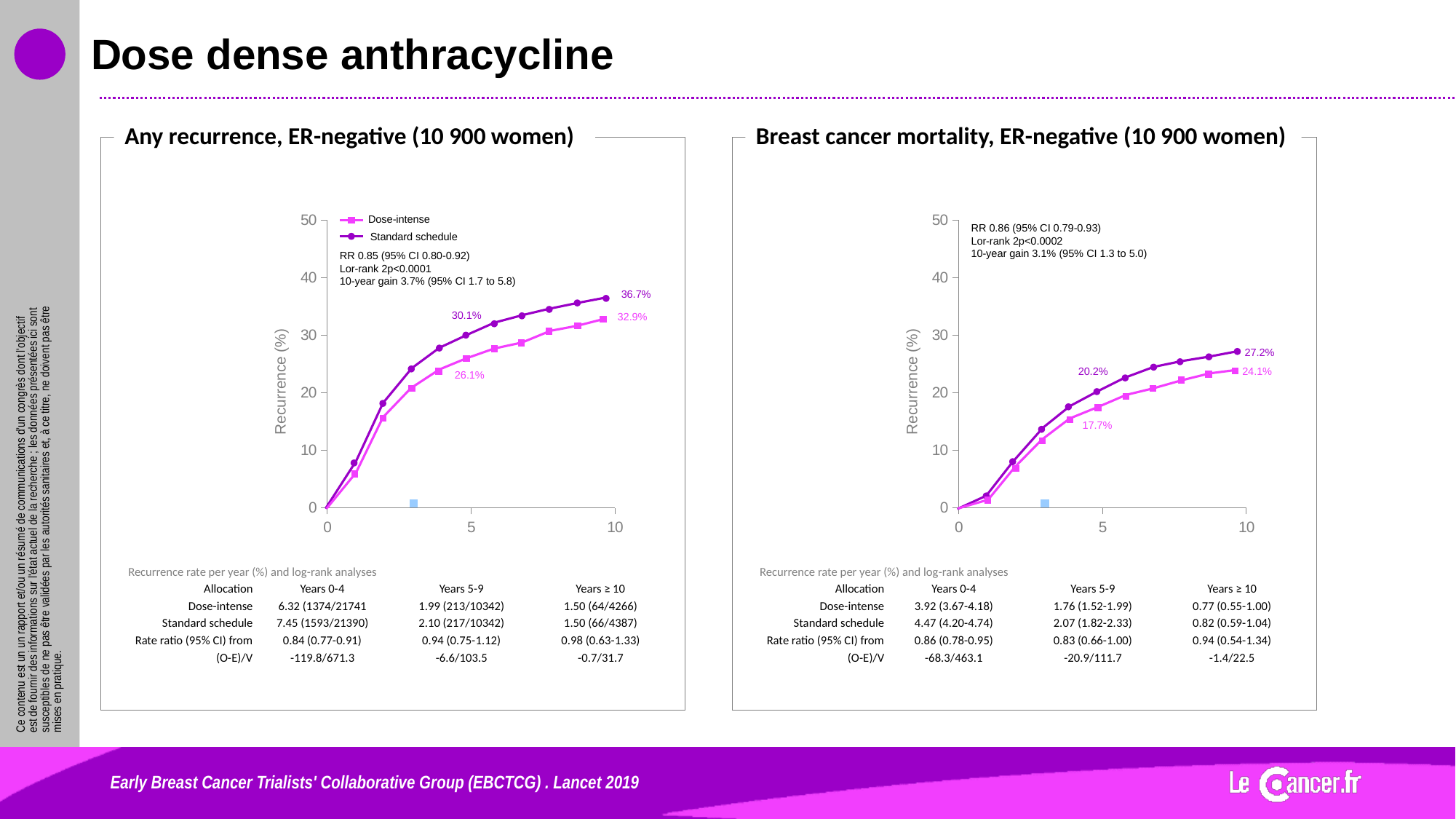
In the 'Breast cancer mortality, ER-negative' chart, what is the 10-year value labelled for the Standard schedule line? 27.2% In the 'Any recurrence, ER-negative' chart, what is the 5-year value labelled for the Dose-intense line? 26.1% What kind of chart is the 'Breast cancer mortality, ER-negative' chart? Line chart In the 'Breast cancer mortality, ER-negative' chart, what is the difference between the 5-year values of the Standard schedule and Dose-intense lines? 2.5% In the 'Any recurrence, ER-negative' chart, is the 10-year value for the Dose-intense line greater or less than 30? greater How many series does the legend of the 'Any recurrence, ER-negative' chart list? 2 In the 'Breast cancer mortality, ER-negative' chart, which line is higher at 10 years, Dose-intense or Standard schedule? Standard schedule In the 'Any recurrence, ER-negative' chart, what is the 10-year recurrence value labelled for the Standard schedule line? 36.7% In the 'Breast cancer mortality, ER-negative' chart, what is the 5-year value labelled for the Dose-intense line? 17.7% In the 'Any recurrence, ER-negative' chart, do the values rise or fall as years increase along the x axis? Rise In the 'Any recurrence, ER-negative' chart, what is the 10-year recurrence value labelled for the Dose-intense line? 32.9% In the 'Any recurrence, ER-negative' chart, what is the difference between the 10-year values of the Standard schedule and Dose-intense lines? 3.8%